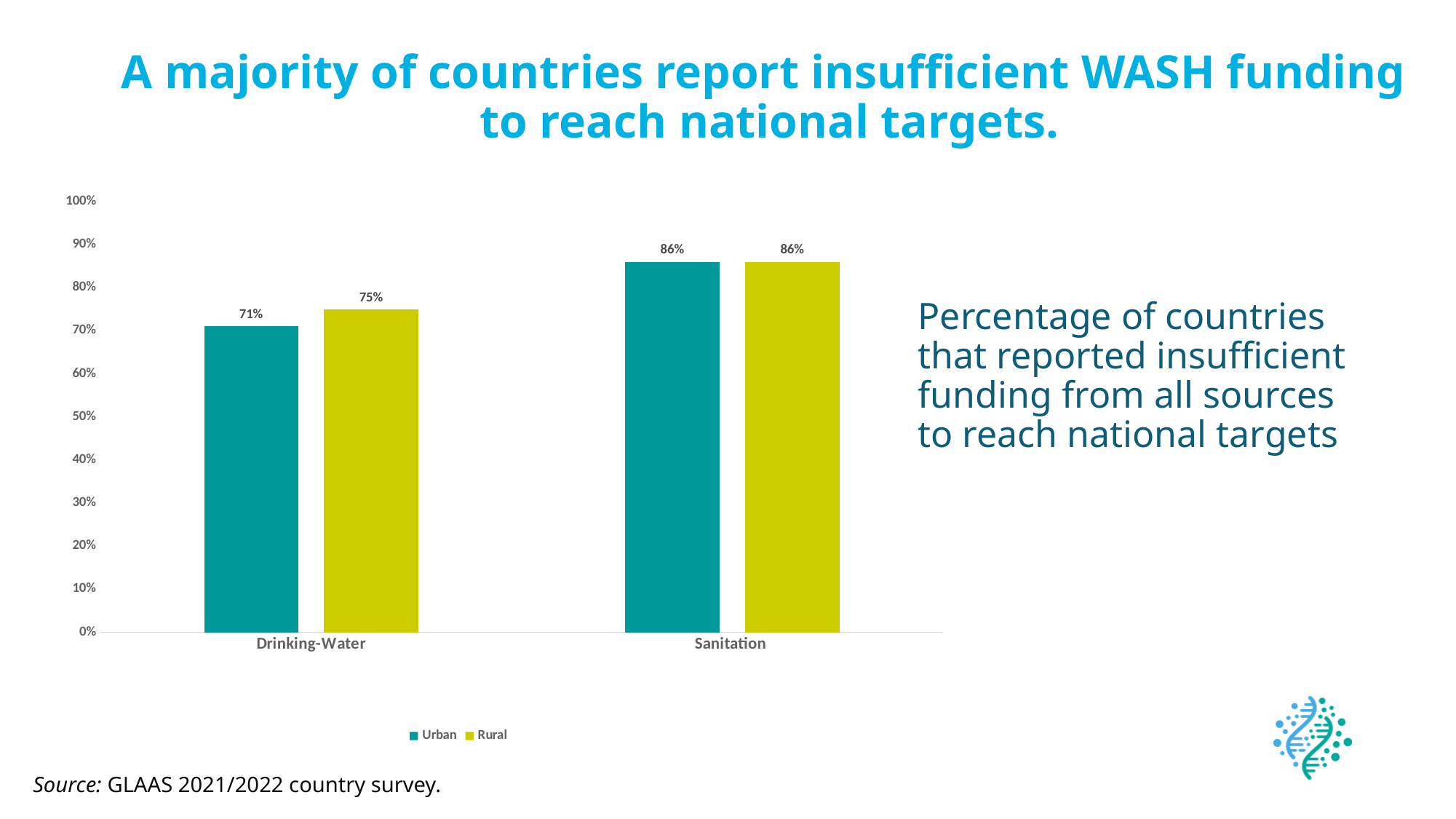
What is the Rural value for Drinking-Water? 75% What kind of chart is shown on the slide? Bar chart What is the Urban value for Sanitation? 86% What is the Urban value for Drinking-Water? 71% What is the difference between the Urban values for Sanitation and Drinking-Water? 15% Which category has the lowest Urban value? Drinking-Water Which is larger for Drinking-Water, the Urban value or the Rural value? Rural What is the Rural value for Sanitation? 86% How many series does the legend list? 2 How many categories are shown on the x axis? 2 What is the difference between the Rural and Urban values for Drinking-Water? 4% Which category has the highest Rural value? Sanitation